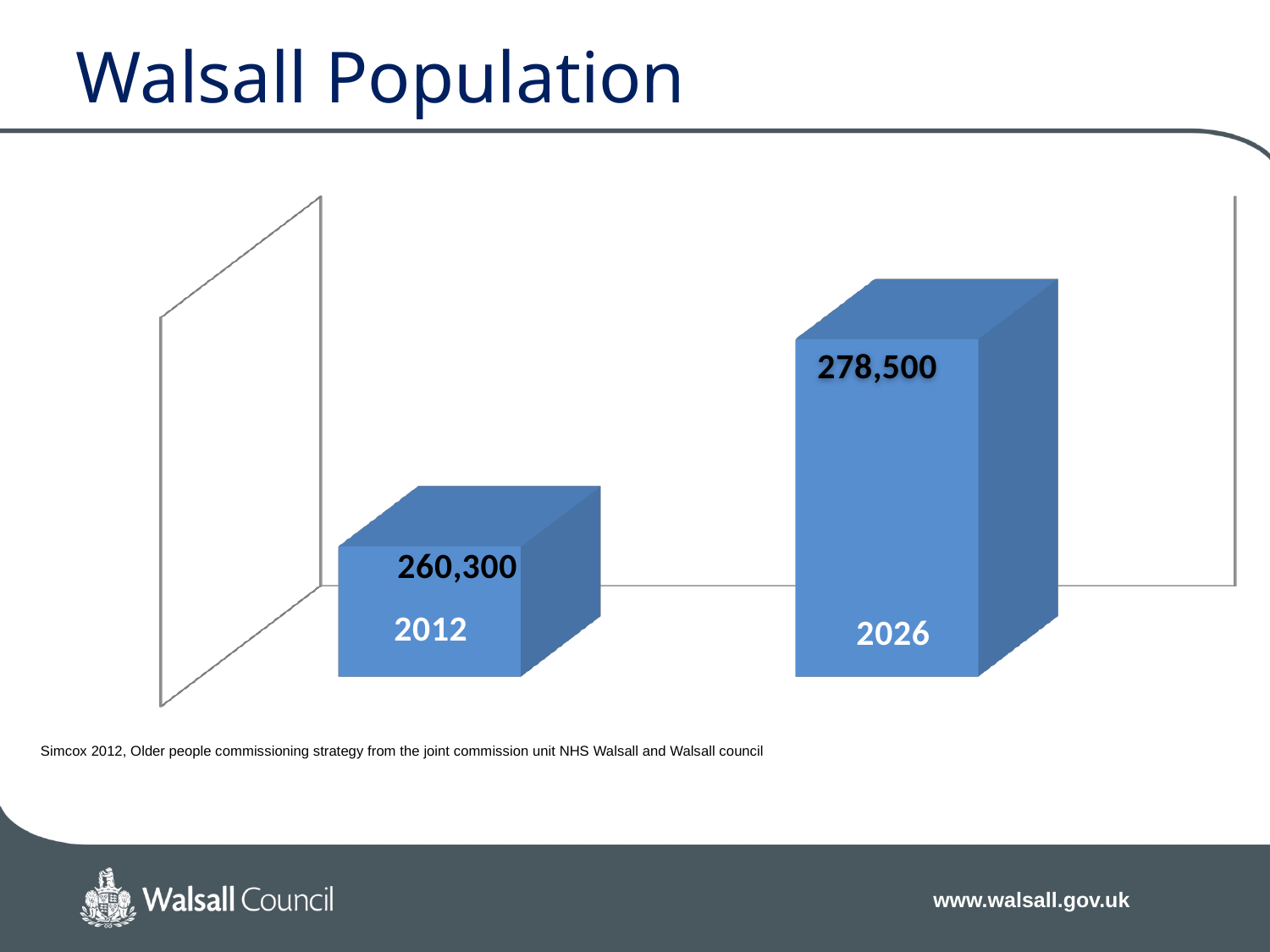
What is the title of the slide containing the chart? Walsall Population Is the population value for 2026 larger or smaller than the value for 2012? larger Which year has the higher population value? 2026 What is the Walsall population value shown for 2012? 260,300 Which year has the lower population value? 2012 What colour are the bars on the chart? blue How many bars are plotted on the chart? 2 Does the population value rise or fall from 2012 to 2026? rise What is the Walsall population value shown for 2026? 278,500 What is the difference between the 2026 and 2012 population values? 18,200 What kind of chart is shown on the slide? bar chart